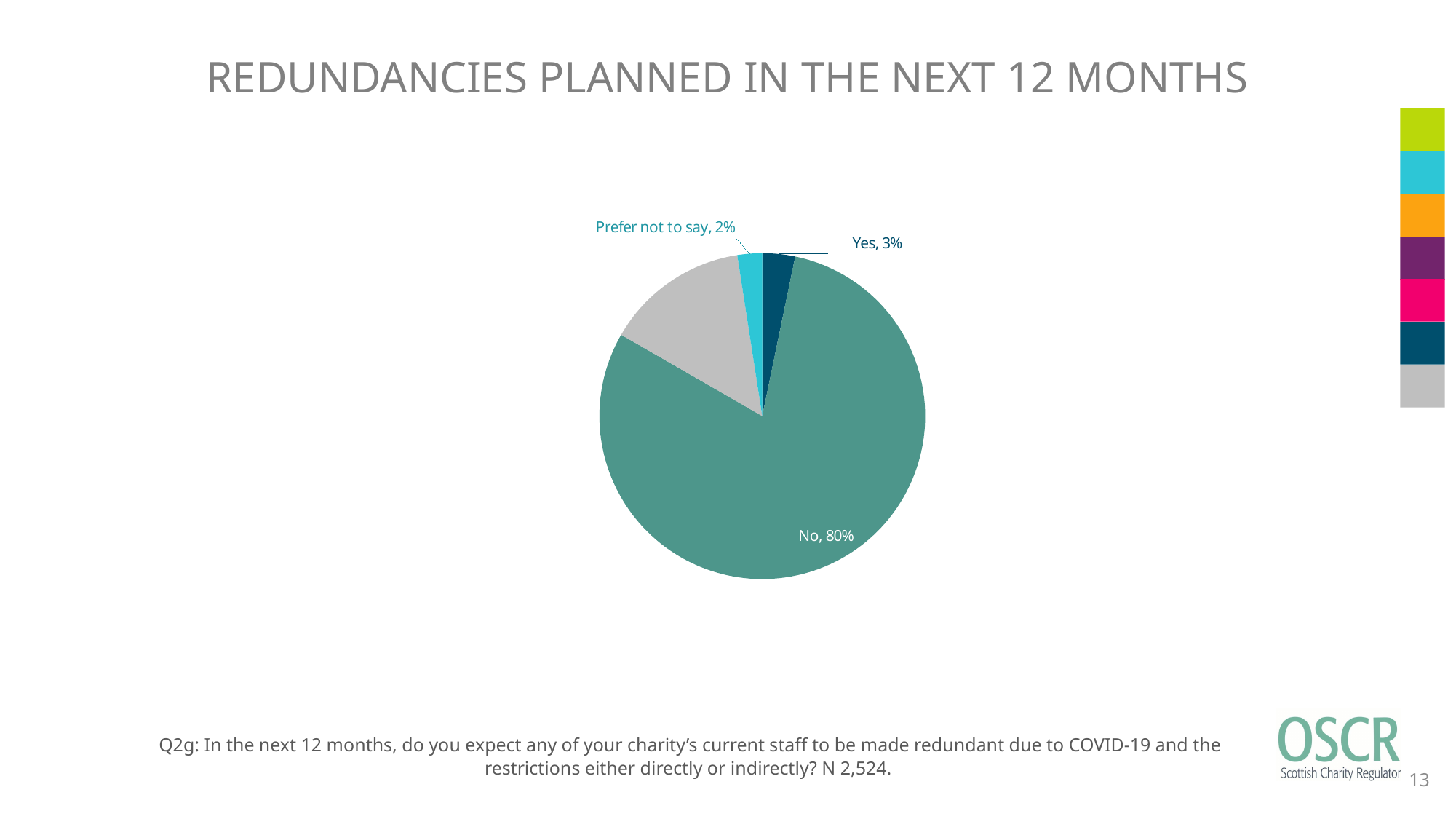
Which labelled category has the smallest share of the pie? Prefer not to say What percentage of respondents answered "No"? 80% What is the difference in percentage points between "Yes" and "Prefer not to say"? 1 percentage point Which labelled category has the largest share of the pie? No What percentage of respondents answered "Yes"? 3% What is the title of the chart? REDUNDANCIES PLANNED IN THE NEXT 12 MONTHS How many slices of the pie have a data label? 3 What is the difference in percentage points between "No" and "Yes"? 77 percentage points Which is larger, the share for "Yes" or the share for "Prefer not to say"? Yes What percentage of respondents chose "Prefer not to say"? 2% What type of chart is shown on the slide? Pie chart What is the sample size (N) stated in the footnote below the chart? 2,524